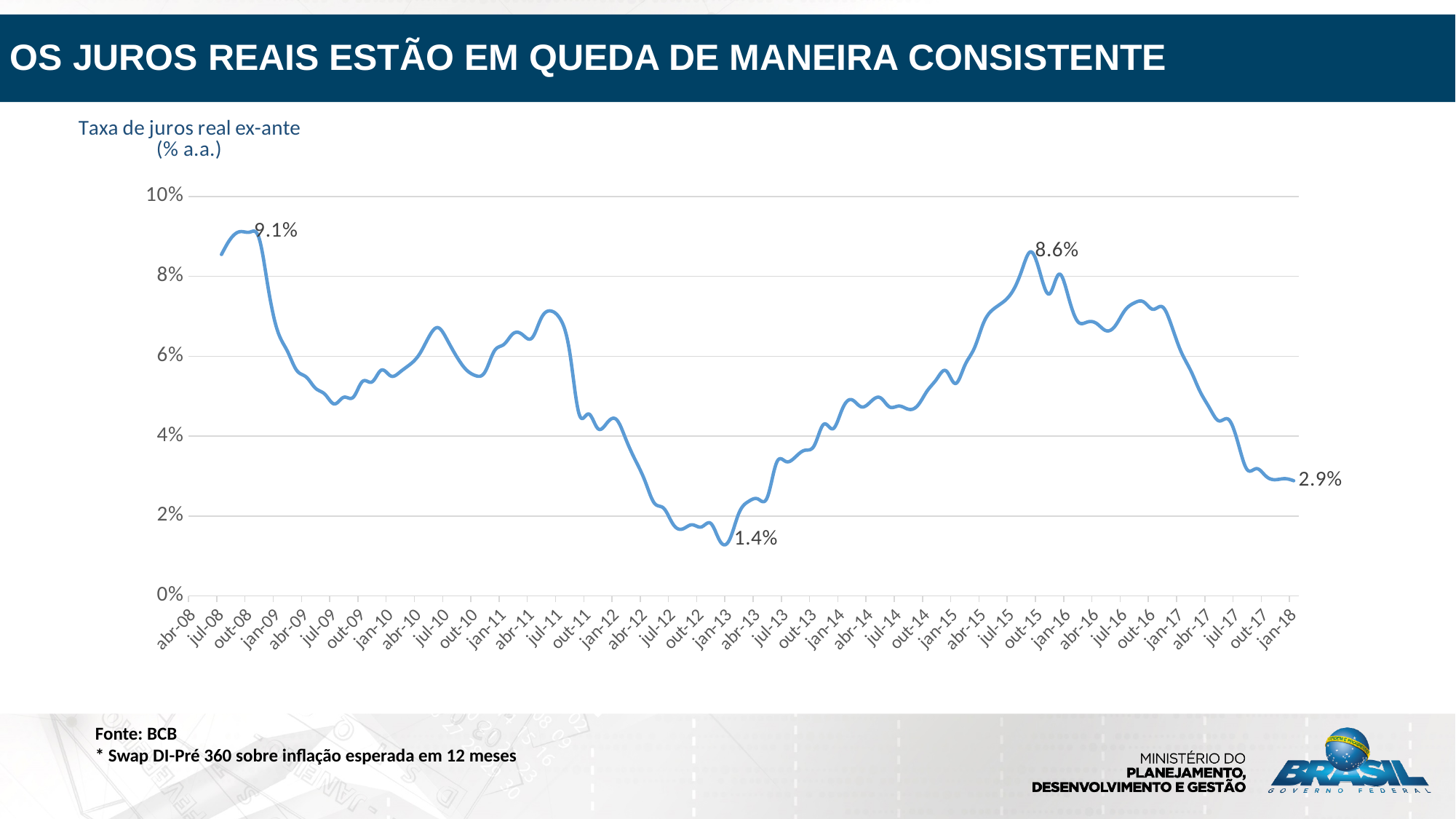
What kind of chart is shown on the slide? line chart What value is labelled at the peak near out-15? 8.6% Is the value around jul-17 greater or less than 6%? less What is the difference between the labelled values 8.6% and 1.4%? 7.2 percentage points What is the lowest labelled value on the chart? 1.4% What is the highest labelled value on the chart? 9.1% What is the title of the chart? Taxa de juros real ex-ante (% a.a.) Is the value around jul-11 greater or less than 6%? greater What is the value of the real ex-ante interest rate at the end of the series (jan-18)? 2.9% What is the difference between the labelled peak of 9.1% and the final value of 2.9%? 6.2 percentage points Does the line rise or fall between out-16 and jan-18? fall Which labelled peak is higher, the one near out-08 or the one near out-15? the one near out-08 (9.1%)